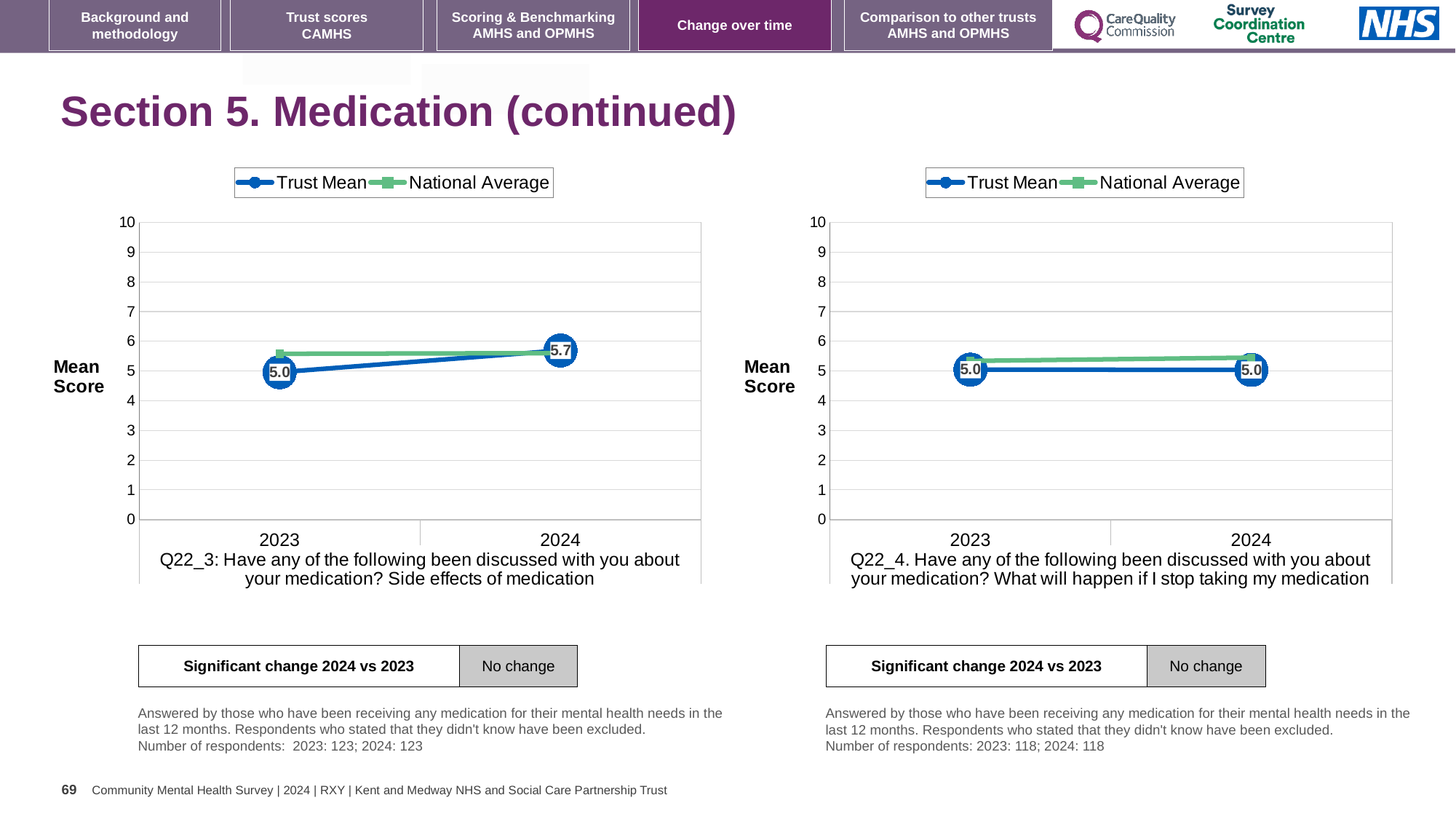
How many years are shown on the x axis of the right chart (Q22_4)? 2 How many series does the legend of the left chart list? 2 What type of chart is used for Q22_3 on the left? line chart In the left chart (Q22_3), what is the Trust Mean for 2024? 5.7 In the left chart (Q22_3), is the National Average for 2023 greater or less than 5? greater In the right chart (Q22_4), does the Trust Mean rise, fall or stay the same from 2023 to 2024? stay the same In the left chart (Q22_3), does the Trust Mean rise or fall from 2023 to 2024? rise In the left chart (Q22_3), by how much did the Trust Mean change from 2023 to 2024? 0.7 In the right chart (Q22_4), what is the Trust Mean for 2024? 5.0 In the left chart (Q22_3), what is the Trust Mean for 2023? 5.0 In the left chart (Q22_3), which year has the higher Trust Mean, 2023 or 2024? 2024 In the right chart (Q22_4), is the National Average for 2024 greater or less than 6? less